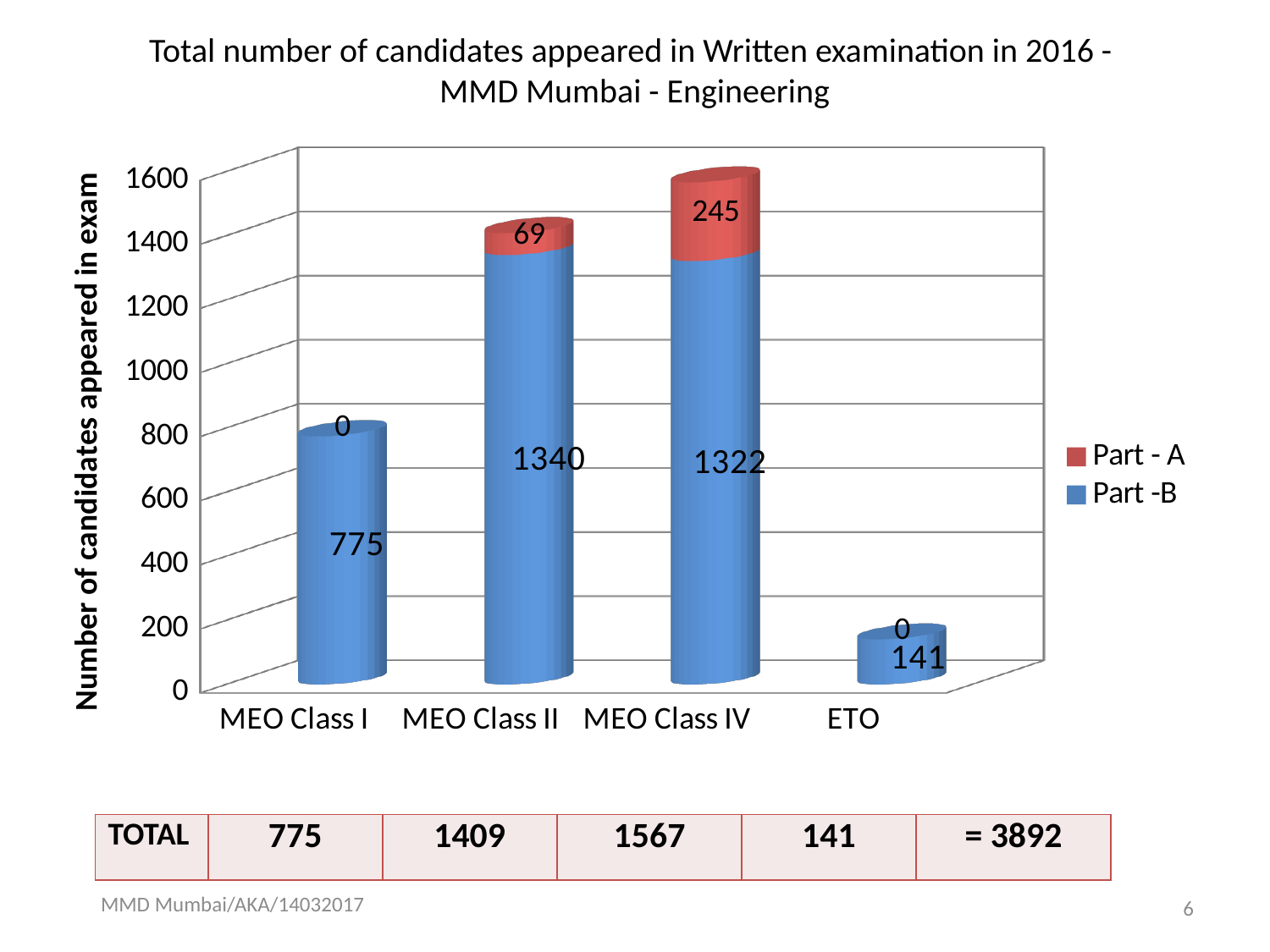
What is the difference between the Part - A values for MEO Class IV and MEO Class II? 176 What is the Part -B value for MEO Class II? 1340 What is the Part - A value for MEO Class I? 0 Which is larger, the Part -B value for MEO Class I or for ETO? MEO Class I How many categories are shown on the x axis? 4 What is the Part - A value for MEO Class IV? 245 What is the total of the stacked bar for MEO Class IV? 1567 How many series does the legend list? 2 What kind of chart is shown on the slide? Stacked bar chart Which category has the highest Part -B value? MEO Class II What is the Part -B value for ETO? 141 Which category has the lowest Part -B value? ETO